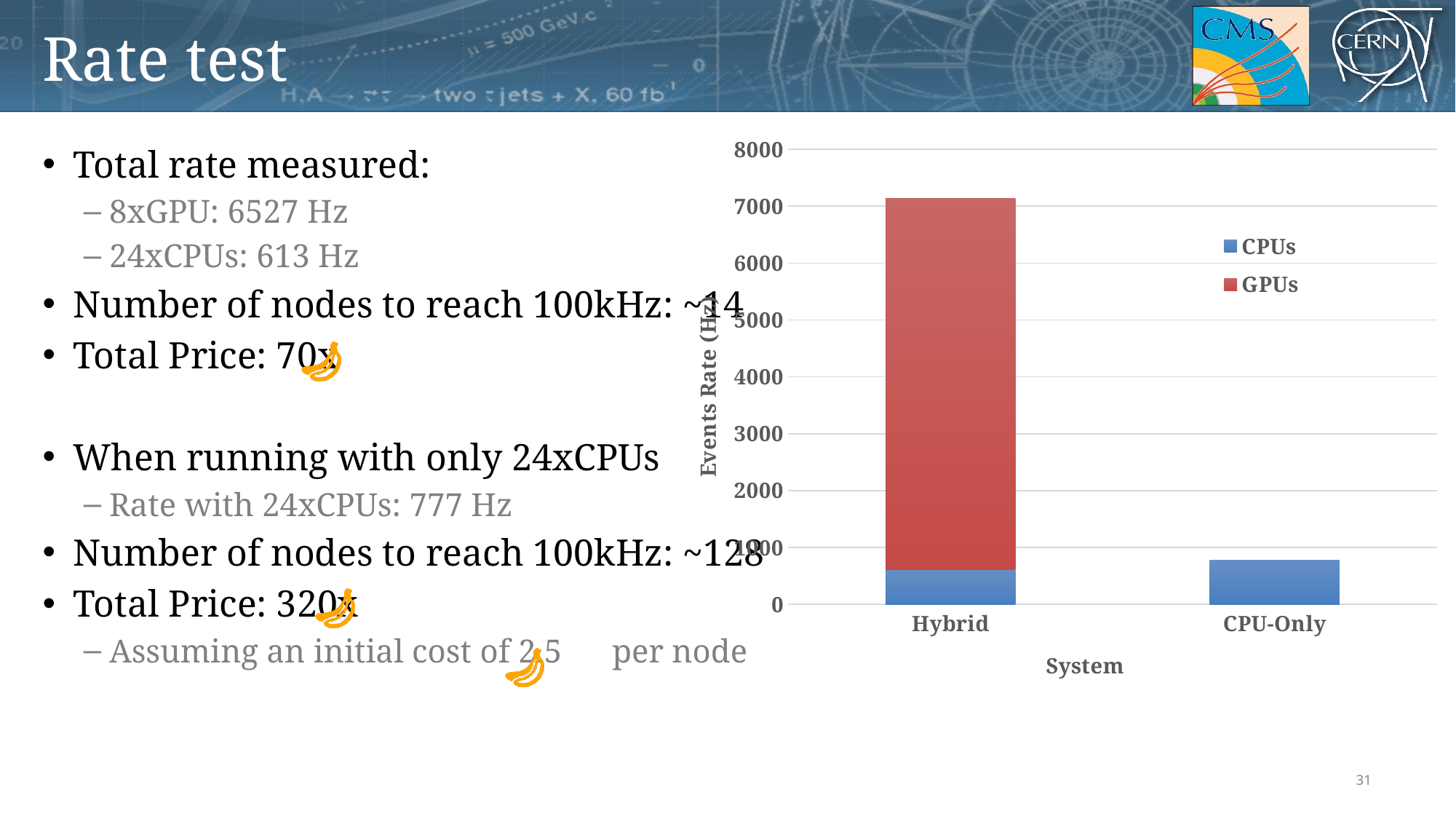
Which has a larger total events rate, Hybrid or CPU-Only? Hybrid Which system has the lowest total events rate in the chart? CPU-Only Is the CPUs portion of the Hybrid bar greater or less than 1000? less What kind of chart is shown on the slide? bar chart How many series does the chart legend list? 2 Is the total value for Hybrid greater or less than 6000? greater Is the total value for CPU-Only greater or less than 1000? less How many categories are shown on the x axis of the chart? 2 Which system has the highest total events rate in the chart? Hybrid What is the title of the y axis of the chart? Events Rate (Hz) What is the title of the x axis of the chart? System